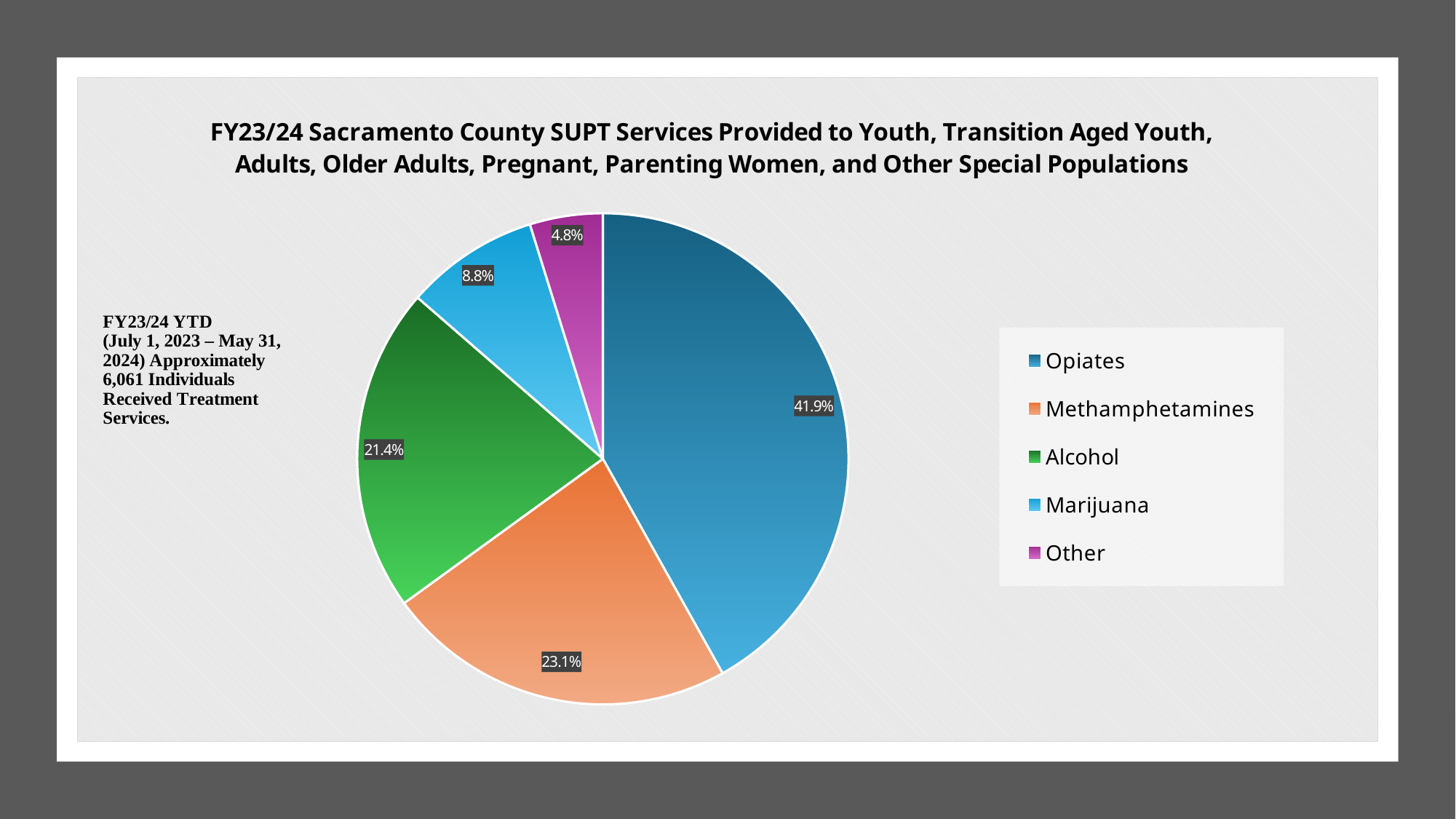
Which has a larger share, Marijuana or Other? Marijuana What percentage of the pie chart is Methamphetamines? 23.1% Which category has the smallest share of the pie chart? Other What percentage of the pie chart is Opiates? 41.9% What colour is the Alcohol slice in the pie chart? Green What type of chart is shown on the slide? Pie chart What percentage of the pie chart is Marijuana? 8.8% How many categories are shown in the pie chart? 5 What is the difference in percentage points between Opiates and Methamphetamines? 18.8 What percentage of the pie chart is Other? 4.8% What percentage of the pie chart is Alcohol? 21.4% Which category has the largest share of the pie chart? Opiates